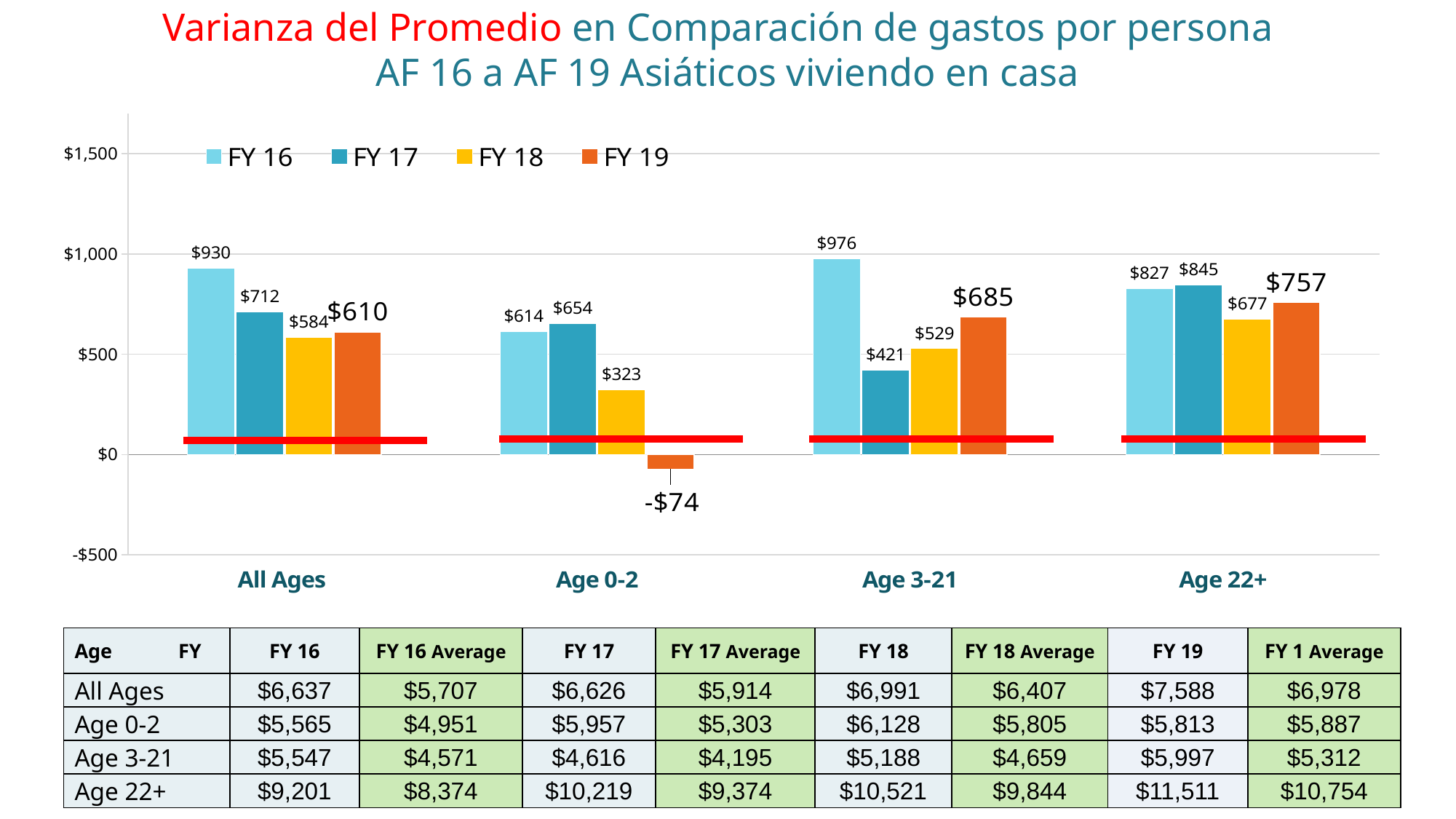
How many age categories are shown on the x axis? 4 Which age category has the highest FY 16 value? Age 3-21 What kind of chart is shown? Bar chart What is the difference between the FY 16 and FY 17 values for All Ages? $218 What is the FY 17 value for Age 22+? $845 Which age category has the lowest FY 18 value? Age 0-2 What is the FY 18 value for Age 3-21? $529 What is the FY 16 value for All Ages? $930 How many series does the legend list? 4 What is the FY 19 value for Age 0-2? -$74 Which series is shown in orange in the legend? FY 19 Which is larger for Age 3-21: the FY 17 value or the FY 19 value? FY 19